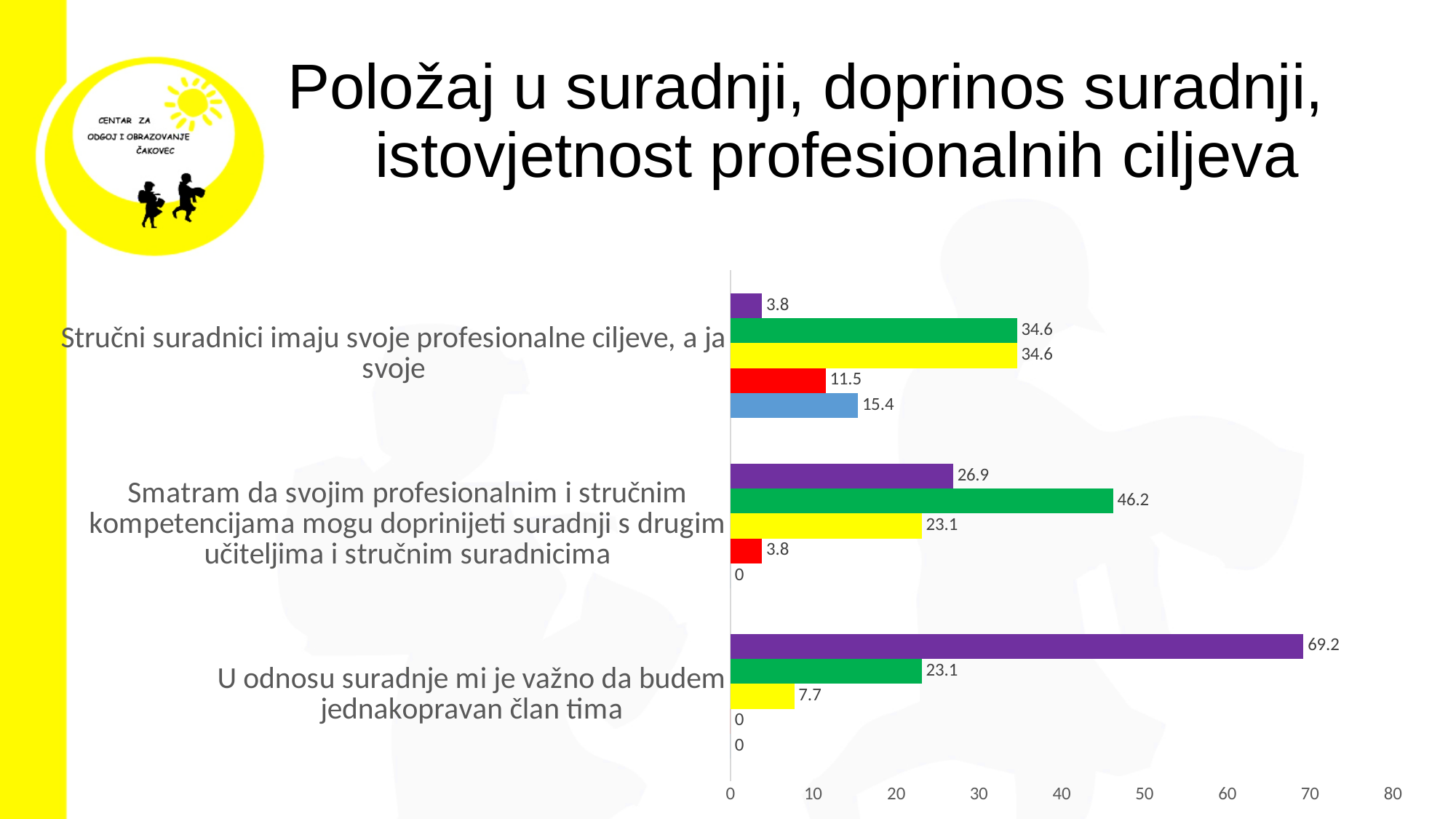
What is the value of the blue bar for "Stručni suradnici imaju svoje profesionalne ciljeve, a ja svoje"? 15.4 What is the value of the red bar for "Stručni suradnici imaju svoje profesionalne ciljeve, a ja svoje"? 11.5 Is the value of the green bar for "Stručni suradnici imaju svoje profesionalne ciljeve, a ja svoje" greater or less than 30? greater How many bars are plotted for each category on the chart? 5 What is the value of the green bar for "Smatram da svojim profesionalnim i stručnim kompetencijama mogu doprinijeti suradnji s drugim učiteljima i stručnim suradnicima"? 46.2 Which category has the lowest purple bar? Stručni suradnici imaju svoje profesionalne ciljeve, a ja svoje What is the value of the purple bar for "U odnosu suradnje mi je važno da budem jednakopravan član tima"? 69.2 What is the difference between the purple bar and the green bar for "U odnosu suradnje mi je važno da budem jednakopravan član tima"? 46.1 How many categories are shown on the chart? 3 For "Smatram da svojim profesionalnim i stručnim kompetencijama mogu doprinijeti suradnji s drugim učiteljima i stručnim suradnicima", which is larger: the purple bar or the yellow bar? the purple bar Which category has the highest purple bar? U odnosu suradnje mi je važno da budem jednakopravan član tima What type of chart is shown on the slide? bar chart